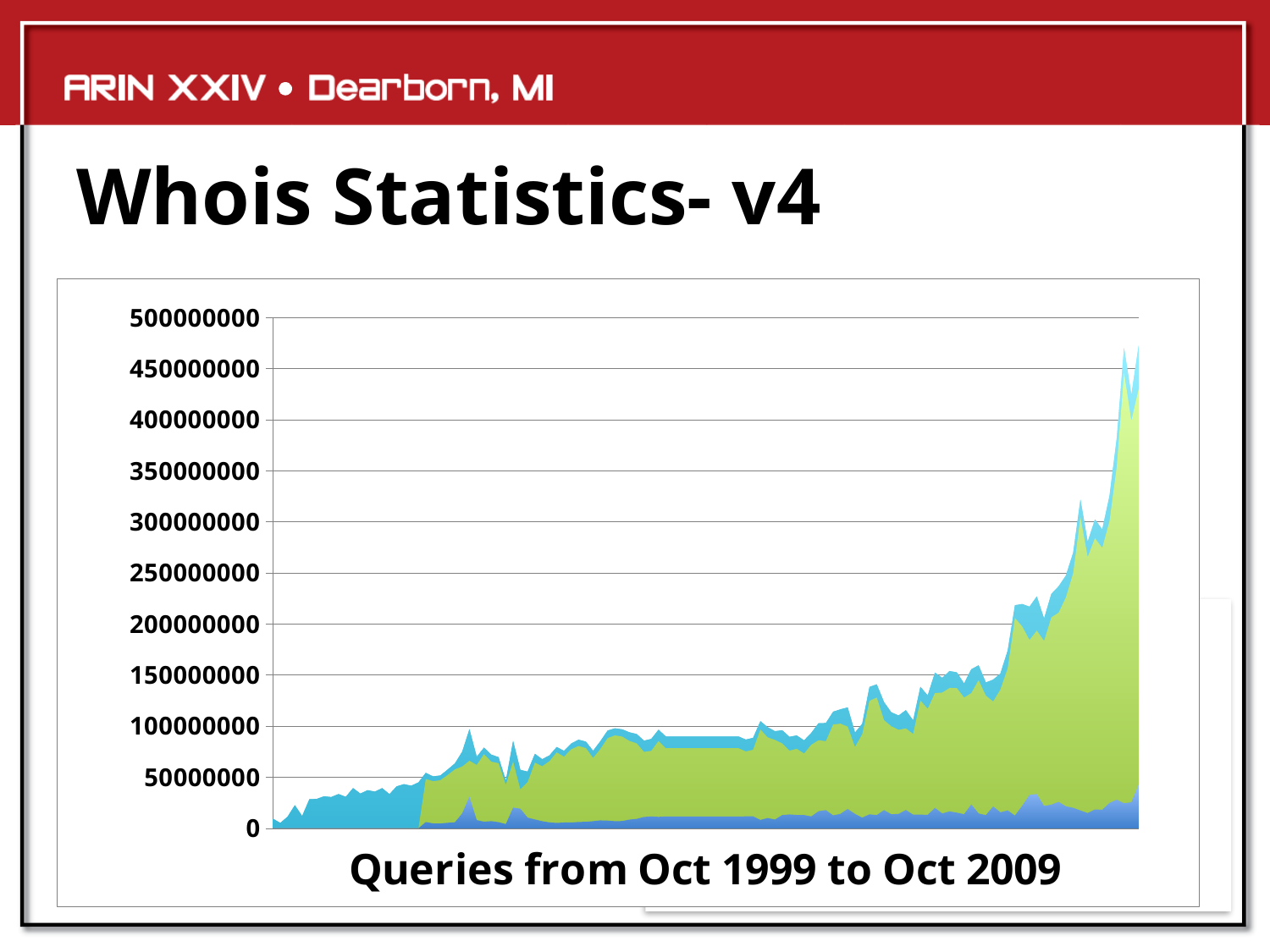
Do the total query values generally rise or fall from Oct 1999 to Oct 2009? Rise What kind of chart is shown on the slide? Area chart What is the highest value shown on the y axis of the chart? 500000000 In which part of the time range does the chart reach its highest total: near the beginning or near the end? Near the end Is the highest total value reached on the chart greater or less than 400000000? greater What is the title of the slide containing the chart? Whois Statistics- v4 Is the total value at the start of the chart (Oct 1999) greater or less than 50000000? less Is the highest total value reached on the chart greater or less than 500000000? less What label appears below the x axis of the chart? Queries from Oct 1999 to Oct 2009